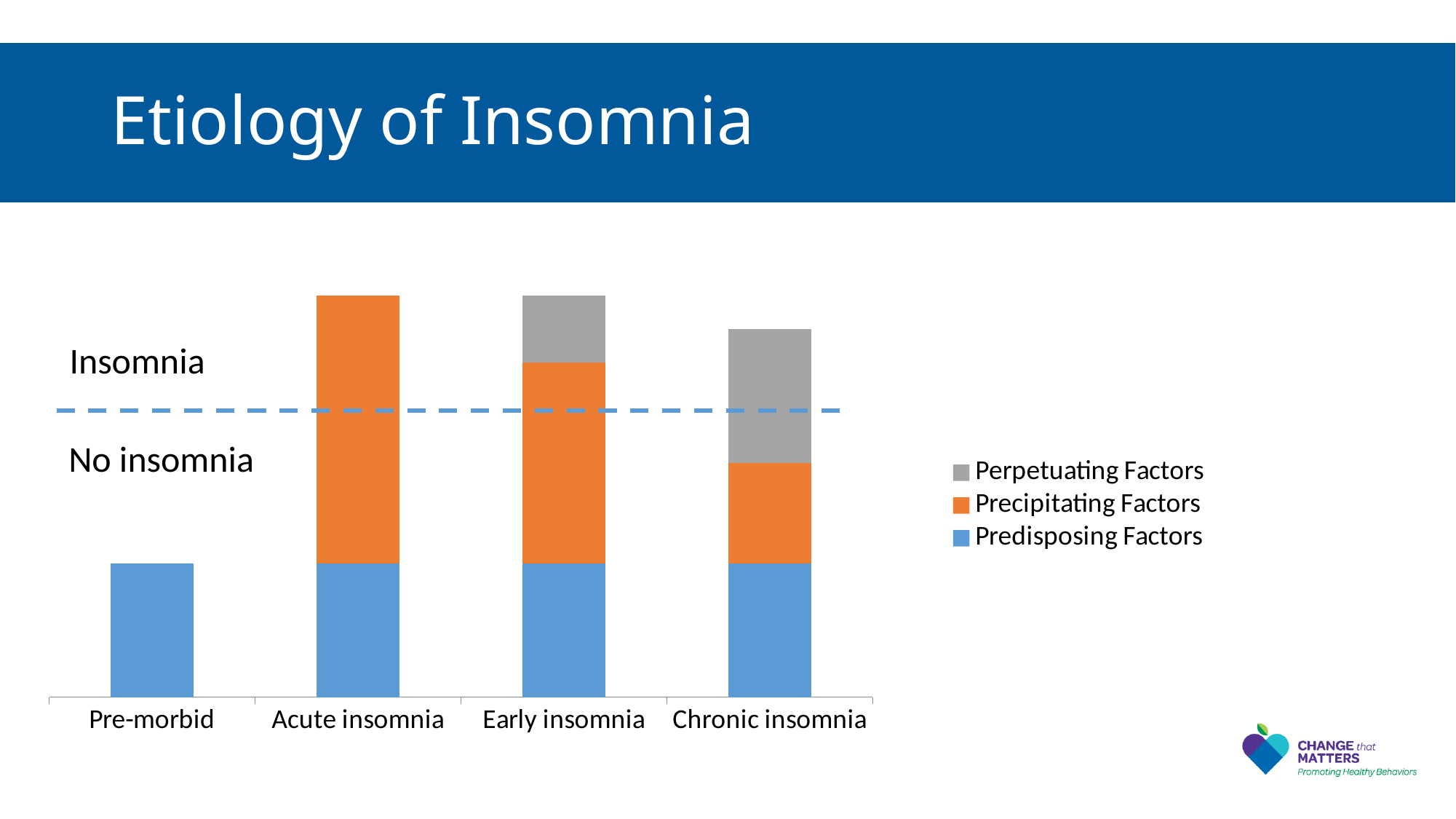
Is the Perpetuating Factors segment larger for Early insomnia or for Chronic insomnia? Chronic insomnia Is the Precipitating Factors segment larger for Acute insomnia or for Chronic insomnia? Acute insomnia What kind of chart is shown on the slide? Stacked bar chart Which series is shown in grey in the legend? Perpetuating Factors How many categories are shown on the x axis of the chart? 4 Which category has the largest Precipitating Factors segment? Acute insomnia Which categories have bars that rise above the dashed insomnia threshold line? Acute insomnia, Early insomnia, Chronic insomnia How many series does the chart's legend list? 3 Is the total bar for Chronic insomnia larger or smaller than the total bar for Pre-morbid? Larger Which category's bar consists only of Predisposing Factors? Pre-morbid Which category has the largest Perpetuating Factors segment? Chronic insomnia Which category has the lowest total bar height? Pre-morbid